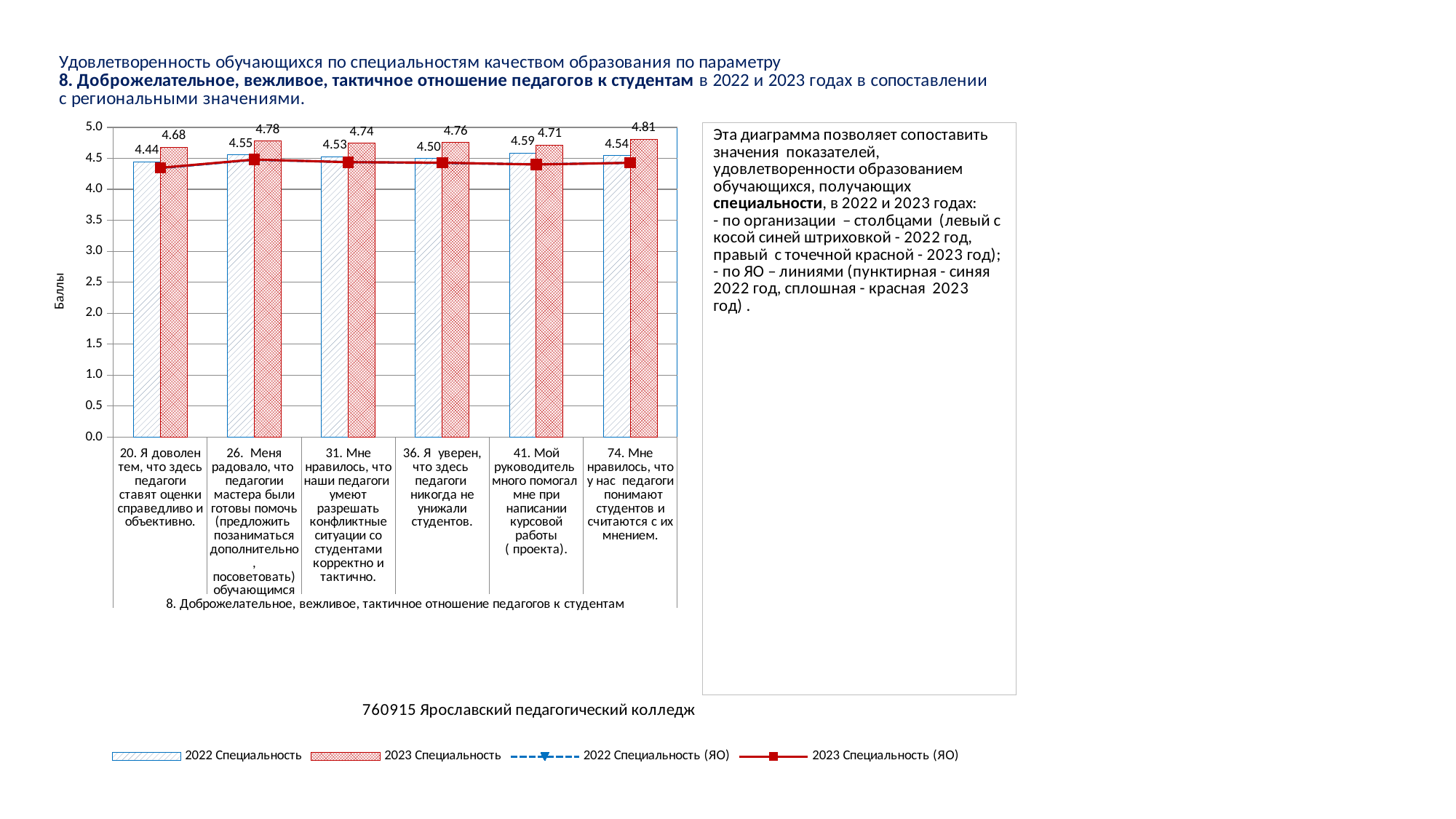
What is the 2022 Специальность value for category 41 (Мой руководитель много помогал мне при написании курсовой работы)? 4.59 Which is larger for category 26: the 2022 Специальность value or the 2023 Специальность value? 2023 Специальность How many series does the legend list? 4 How many categories are shown on the x axis? 6 What is the 2023 Специальность value for category 20 (Я доволен тем, что здесь педагоги ставят оценки справедливо и объективно)? 4.68 Which category has the highest 2023 Специальность value? 74. Мне нравилось, что у нас педагоги понимают студентов и считаются с их мнением. Is the 2023 Специальность (ЯО) line value for category 20 greater or less than 4.0? greater What is the label of the vertical axis? Баллы What is the difference between the 2023 and 2022 Специальность values for category 74? 0.27 What kind of chart is shown on the slide? Combined bar and line chart What is the 2022 Специальность value for category 36 (Я уверен, что здесь педагоги никогда не унижали студентов)? 4.50 Which category has the lowest 2022 Специальность value? 20. Я доволен тем, что здесь педагоги ставят оценки справедливо и объективно.